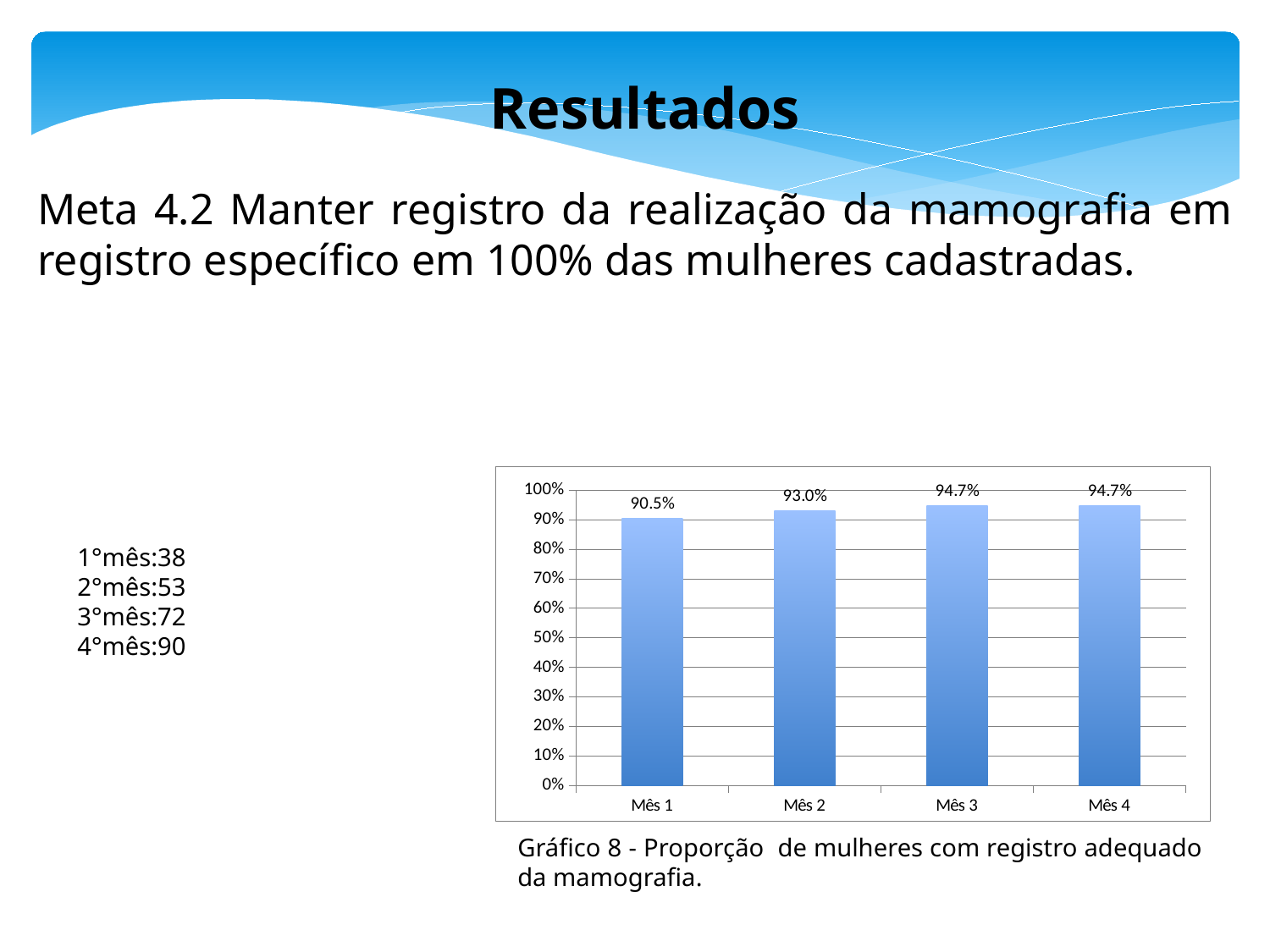
What is the difference between the values for Mês 3 and Mês 1? 4.2 percentage points What is the value for Mês 2? 93.0% What is the value for Mês 4? 94.7% What kind of chart is shown? Bar chart What is the value for Mês 3? 94.7% How many months are shown on the x axis? 4 What is the difference between the values for Mês 2 and Mês 1? 2.5 percentage points Which is larger, the value for Mês 2 or the value for Mês 1? Mês 2 What is the value for Mês 1? 90.5% Which month has the lowest value? Mês 1 Is the value for Mês 1 greater or less than 80%? greater Do the values rise or fall from Mês 1 to Mês 3? Rise